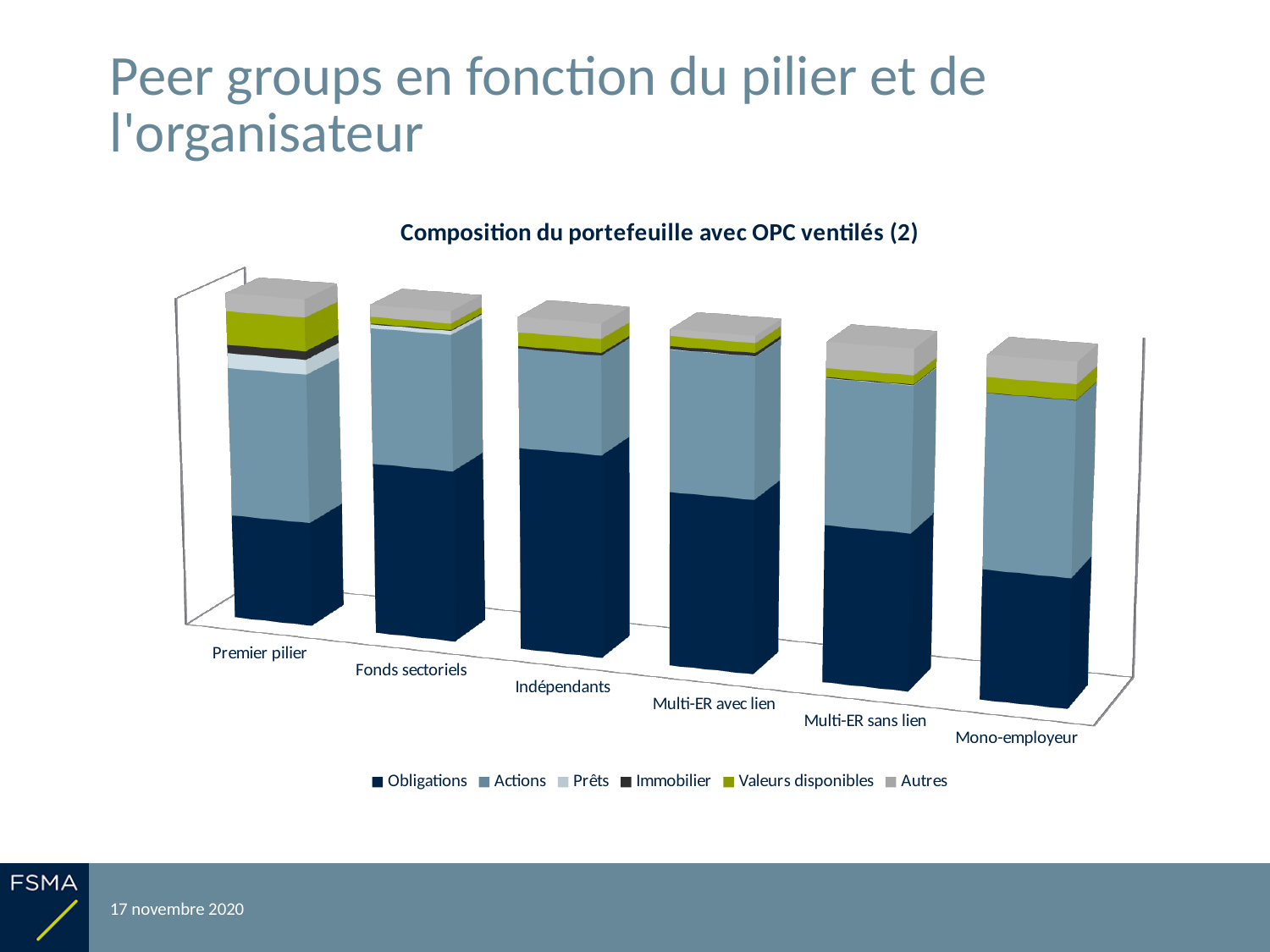
What kind of chart is shown on the slide? Stacked bar chart How many series does the chart legend list? 6 Which series forms the bottom segment of each stacked bar? Obligations How many categories (peer groups) are shown on the x axis of the chart? 6 Which series is listed first in the chart legend? Obligations What is the title of the chart? Composition du portefeuille avec OPC ventilés (2) Which category is shown first (leftmost) on the x axis? Premier pilier Which category is shown furthest to the right on the x axis? Mono-employeur Which category has the largest Prêts segment? Premier pilier Which category has the largest Valeurs disponibles segment? Premier pilier